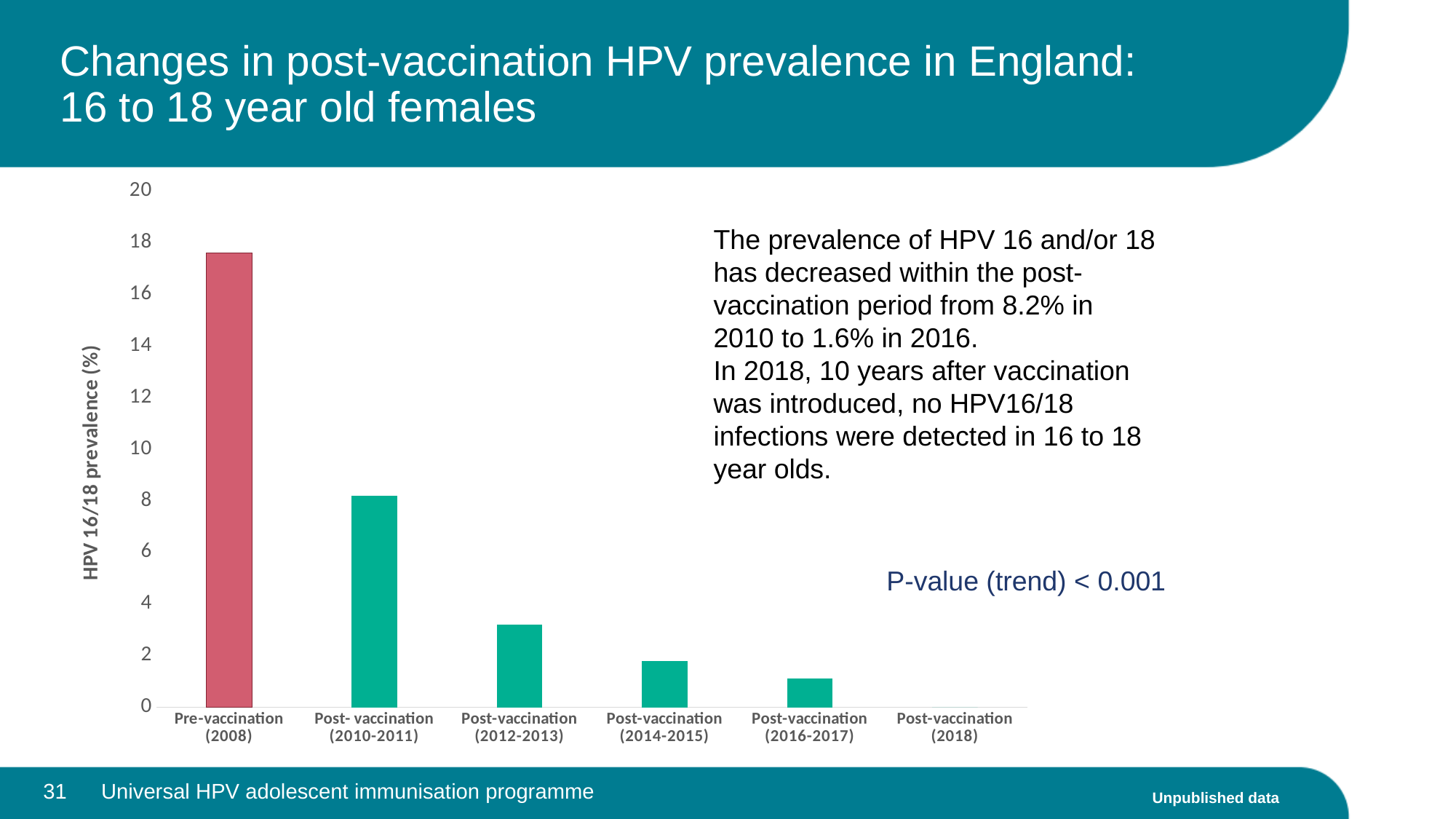
What kind of chart is shown on the slide? bar chart Which category has the highest HPV 16/18 prevalence? Pre-vaccination (2008) Do the values rise or fall from left to right along the x axis? fall What colour is the Pre-vaccination (2008) bar? red Is the value for Pre-vaccination (2008) greater or less than 16? greater How many categories are shown on the x axis of the chart? 6 Which category has the lowest HPV 16/18 prevalence? Post-vaccination (2018) Is the value for Post-vaccination (2010-2011) greater or less than 10? less Is the value for Post-vaccination (2012-2013) greater or less than 2? greater Which is larger, the value for Post-vaccination (2012-2013) or Post-vaccination (2014-2015)? Post-vaccination (2012-2013) What is the label of the y axis? HPV 16/18 prevalence (%)